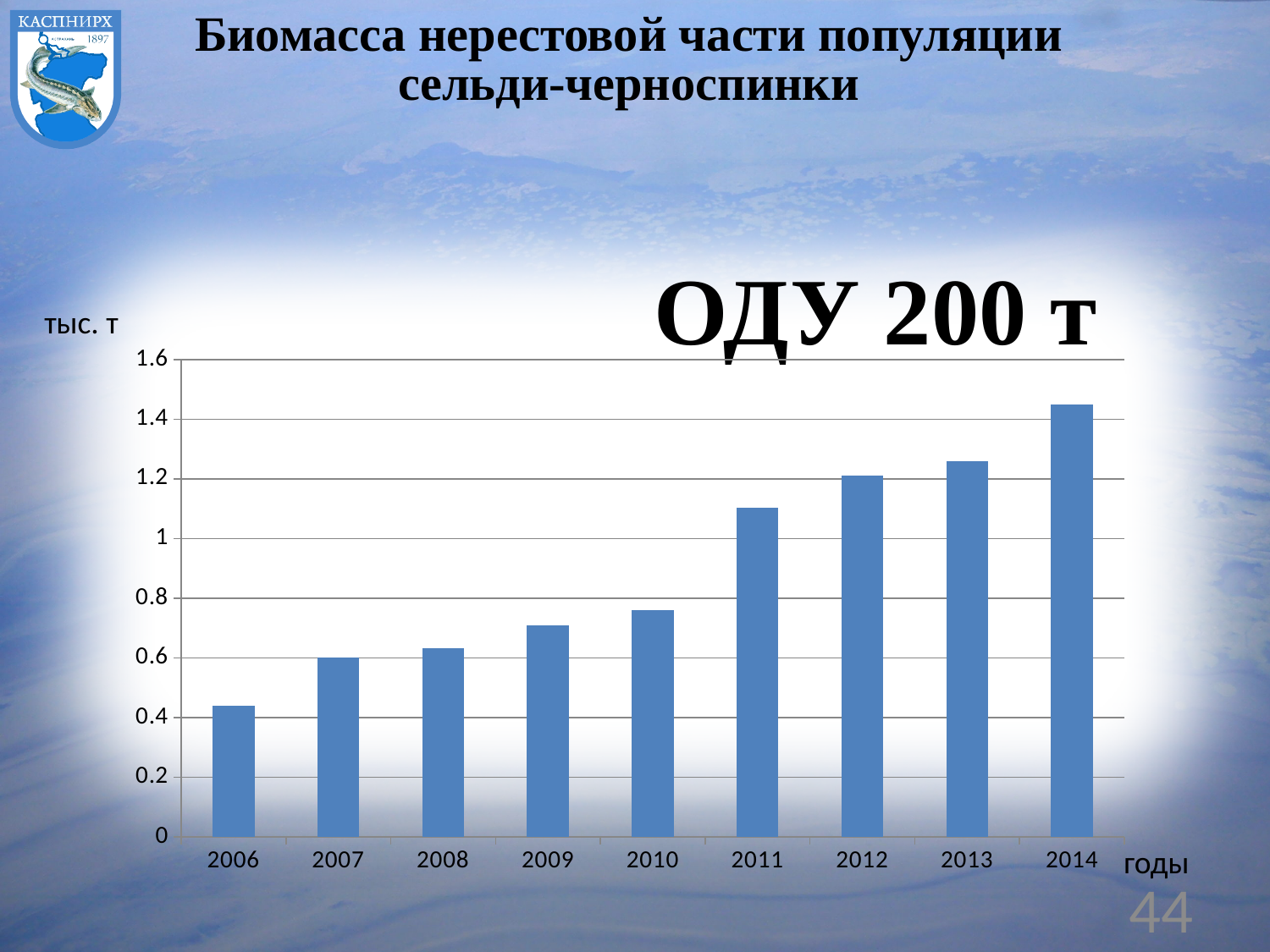
What kind of chart is shown on the slide? bar chart What is the title of the chart on the slide? Биомасса нерестовой части популяции сельди-черноспинки How many years are shown on the x axis of the chart? 9 Which is larger, the value for 2009 or the value for 2012? 2012 Which year has the highest biomass value in the chart? 2014 Is the value for 2006 greater or less than 0.6? less What unit is shown on the vertical axis of the chart? тыс. т Is the value for 2010 greater or less than 0.8? less Which year has the lowest biomass value in the chart? 2006 Is the value for 2011 greater or less than 1? greater Do the values generally rise or fall from 2006 to 2014? rise